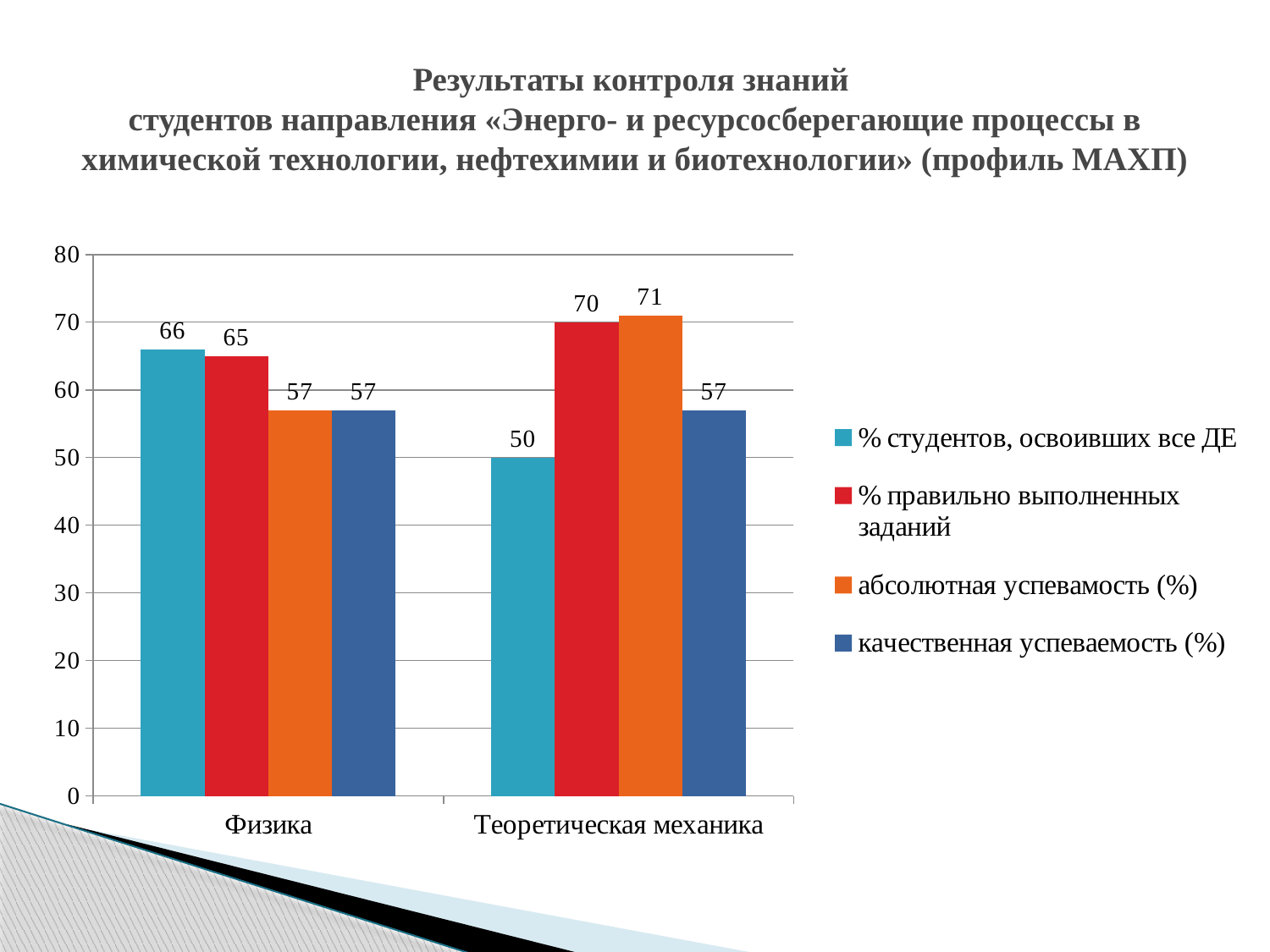
Which is larger: «% правильно выполненных заданий» for Физика or for Теоретическая механика? Теоретическая механика Which series has the highest value for Теоретическая механика? абсолютная успевамость (%) What is the difference between «% студентов, освоивших все ДЕ» for Физика and for Теоретическая механика? 16 Which category has the lowest value for «% студентов, освоивших все ДЕ»? Теоретическая механика How many categories are shown on the x axis? 2 What is the value of «% студентов, освоивших все ДЕ» for Физика? 66 What is the value of «абсолютная успевамость (%)» for Теоретическая механика? 71 What is the value of «качественная успеваемость (%)» for Теоретическая механика? 57 What is the value of «% правильно выполненных заданий» for Физика? 65 What kind of chart is shown on the slide? bar chart Is the value of «% студентов, освоивших все ДЕ» for Теоретическая механика greater or less than 60? less How many series does the legend list? 4